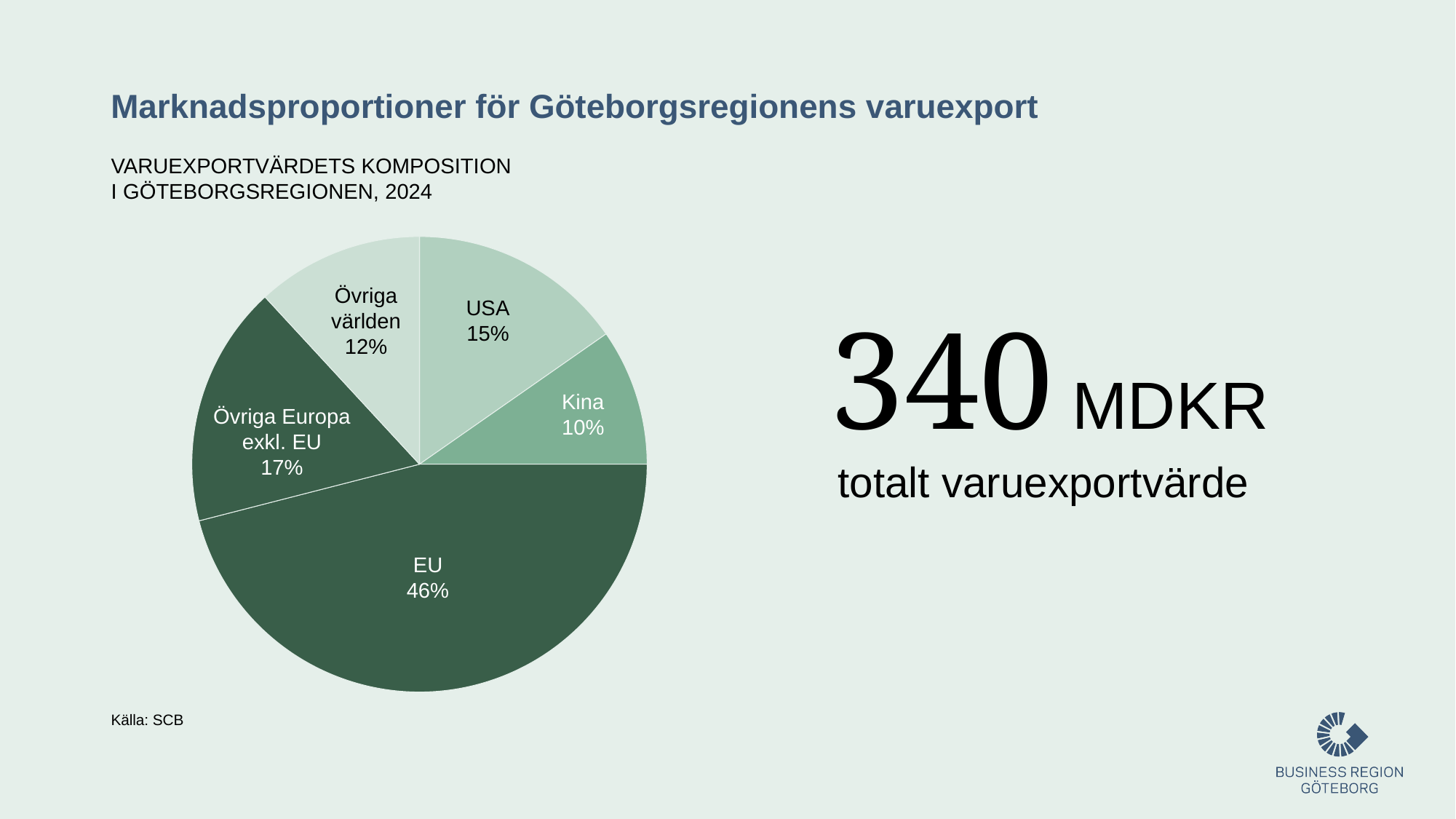
What share of the pie does USA account for? 15% Which is larger, the USA slice or the Övriga världen slice? USA How many slices does the pie chart have? 5 What share of the pie does EU account for? 46% What share of the pie does Kina account for? 10% What is the difference in percentage points between the EU slice and the Övriga Europa exkl. EU slice? 29 percentage points What is the total goods export value stated next to the chart? 340 MDKR What kind of chart is shown on the slide? Pie chart What share of the pie does Övriga Europa exkl. EU account for? 17% What share of the pie does Övriga världen account for? 12% Which slice of the pie is the largest? EU Which slice of the pie is the smallest? Kina